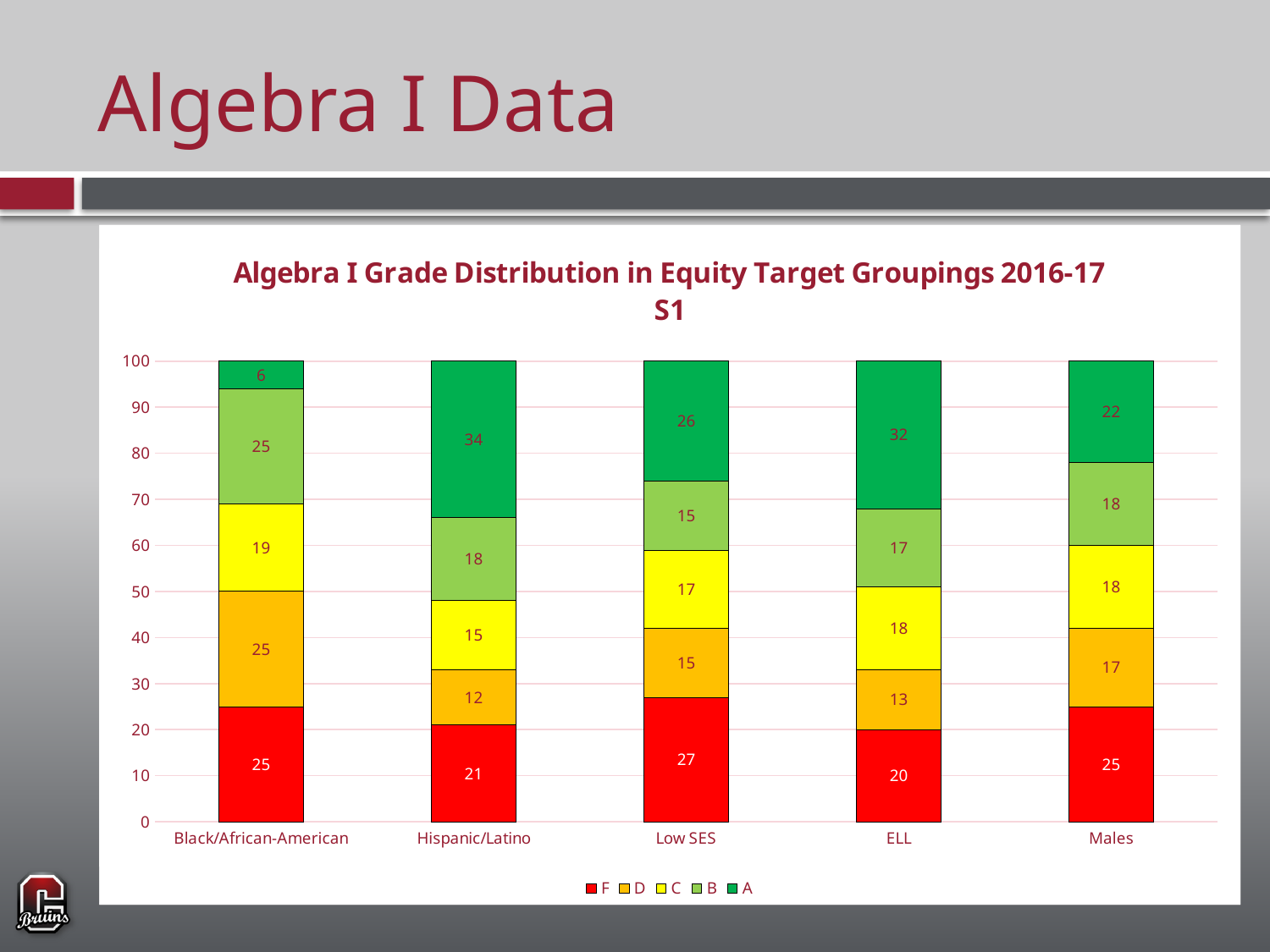
What is the value for D in the ELL group? 13 What is the value for A in the Hispanic/Latino group? 34 Which is larger, the F value for Low SES or the F value for Hispanic/Latino? Low SES How many groups are shown on the x axis? 5 What is the title of the chart? Algebra I Grade Distribution in Equity Target Groupings 2016-17 S1 What is the total of the stacked bar for Males? 100 Which group has the lowest value for F? ELL What is the difference between the A value for ELL and the A value for Black/African-American? 26 Which group has the highest value for A? Hispanic/Latino What kind of chart is shown on the slide? Stacked bar chart What is the value for F in the Low SES group? 27 How many series does the legend list? 5